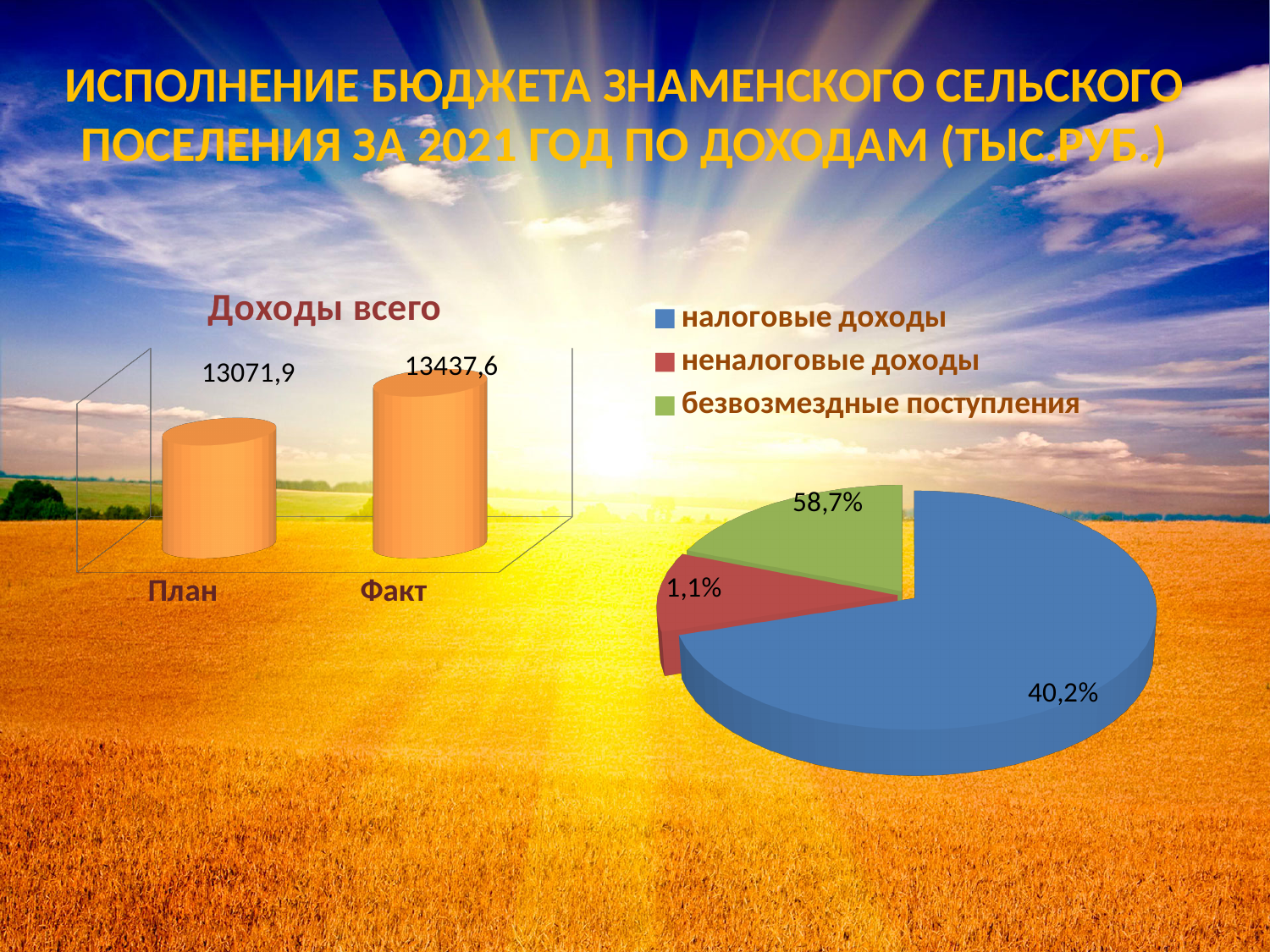
In the chart titled "Доходы всего", what is the value for План? 13071,9 In the chart titled "Доходы всего", what is the difference between the Факт and План values? 365,7 In the chart titled "Доходы всего", how many categories are shown on the x axis? 2 In the pie chart on the right, which category has the smallest slice? неналоговые доходы In the pie chart on the right, what percentage is shown for the smallest slice (неналоговые доходы)? 1,1% In the chart titled "Доходы всего", which category has the higher value, План or Факт? Факт In the chart titled "Доходы всего", which category has the lowest value? План In the pie chart on the right, how many entries does the legend list? 3 In the pie chart on the right, which colour represents налоговые доходы in the legend? blue What kind of chart is shown on the right side of the slide? pie chart What kind of chart is the chart titled "Доходы всего" on the left of the slide? bar chart In the chart titled "Доходы всего", what is the value for Факт? 13437,6